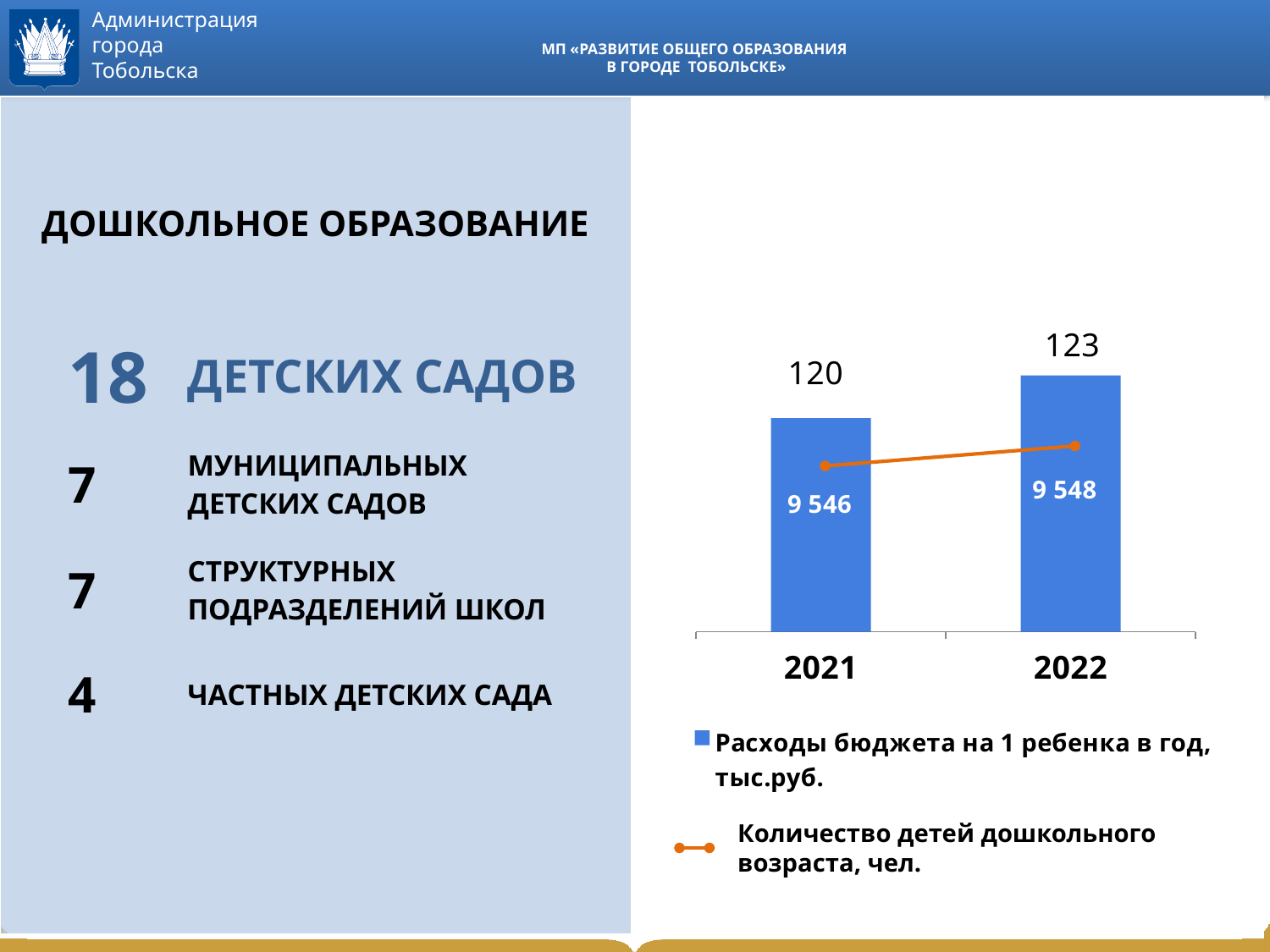
How many series does the chart legend list? 2 What is the value of budget expenses per child per year (тыс.руб.) for 2021? 120 How many preschool-age children (чел.) are shown for 2021? 9 546 What is the difference in the number of preschool-age children between 2022 and 2021? 2 What is the value of budget expenses per child per year (тыс.руб.) for 2022? 123 How many years are shown on the x axis of the chart? 2 How many preschool-age children (чел.) are shown for 2022? 9 548 Is the budget expense per child larger in 2021 or in 2022? 2022 Which year has the higher budget expenses per child? 2022 Which year has the lower number of preschool-age children? 2021 By how much did budget expenses per child per year increase from 2021 to 2022? 3 Do the budget expenses per child rise or fall from 2021 to 2022? rise